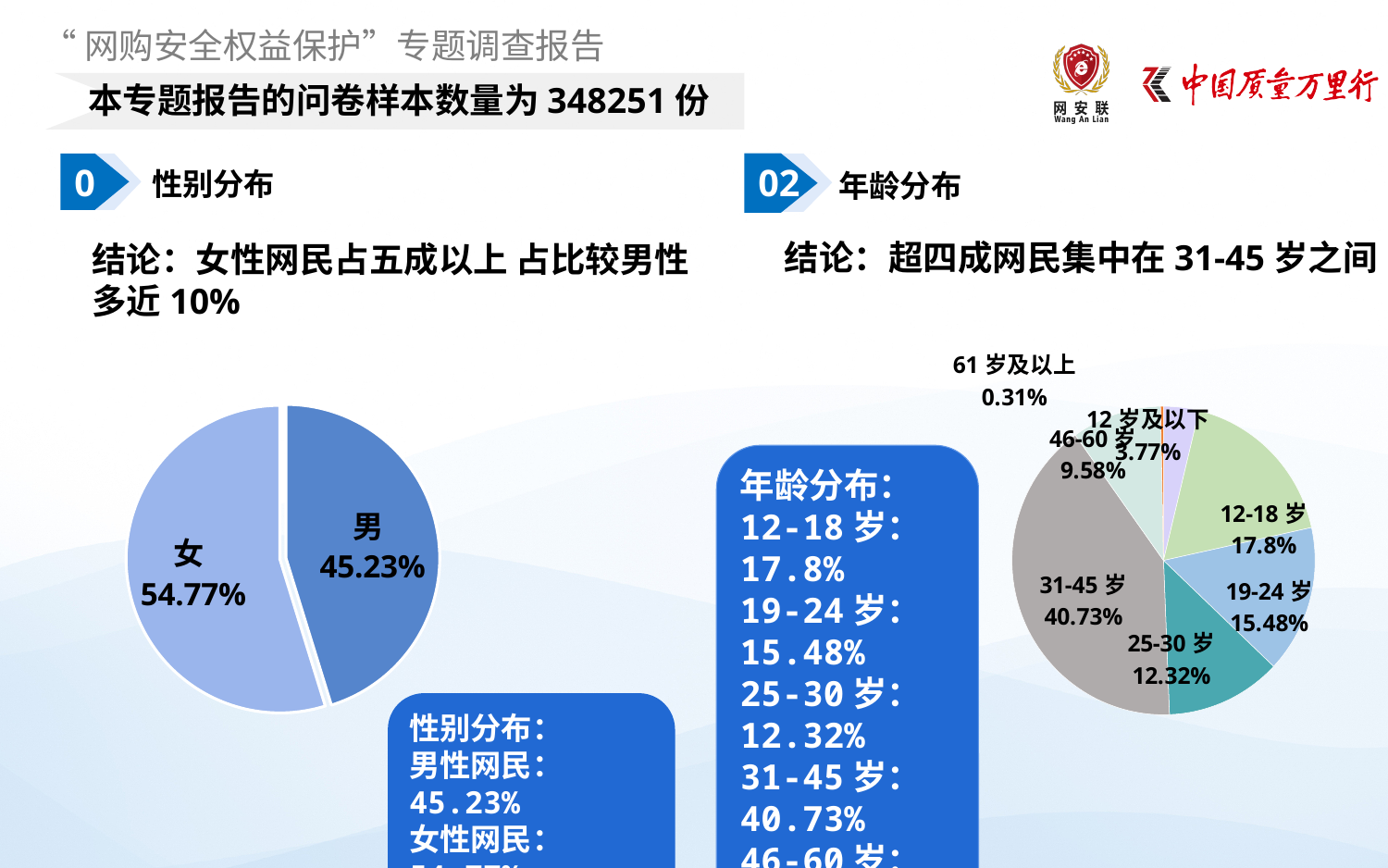
In the gender distribution pie chart (性别分布), what is the difference between the 女 share and the 男 share? 9.54% In the age distribution pie chart (年龄分布), what share is labelled for 12 岁及以下? 3.77% What kind of chart is used for the gender distribution (性别分布)? Pie chart In the gender distribution pie chart (性别分布), what share is labelled for 女? 54.77% In the age distribution pie chart (年龄分布), which age group has the largest share? 31-45 岁 In the gender distribution pie chart (性别分布), which slice is larger, 男 or 女? 女 In the age distribution pie chart (年龄分布), what share is labelled for 31-45 岁? 40.73% In the age distribution pie chart (年龄分布), how many age groups are shown? 7 In the age distribution pie chart (年龄分布), which age group has the smallest share? 61 岁及以上 In the gender distribution pie chart (性别分布), what share is labelled for 男? 45.23% In the age distribution pie chart (年龄分布), which is larger, the share for 19-24 岁 or the share for 25-30 岁? 19-24 岁 In the age distribution pie chart (年龄分布), what is the difference between the 12-18 岁 share and the 46-60 岁 share? 8.22%